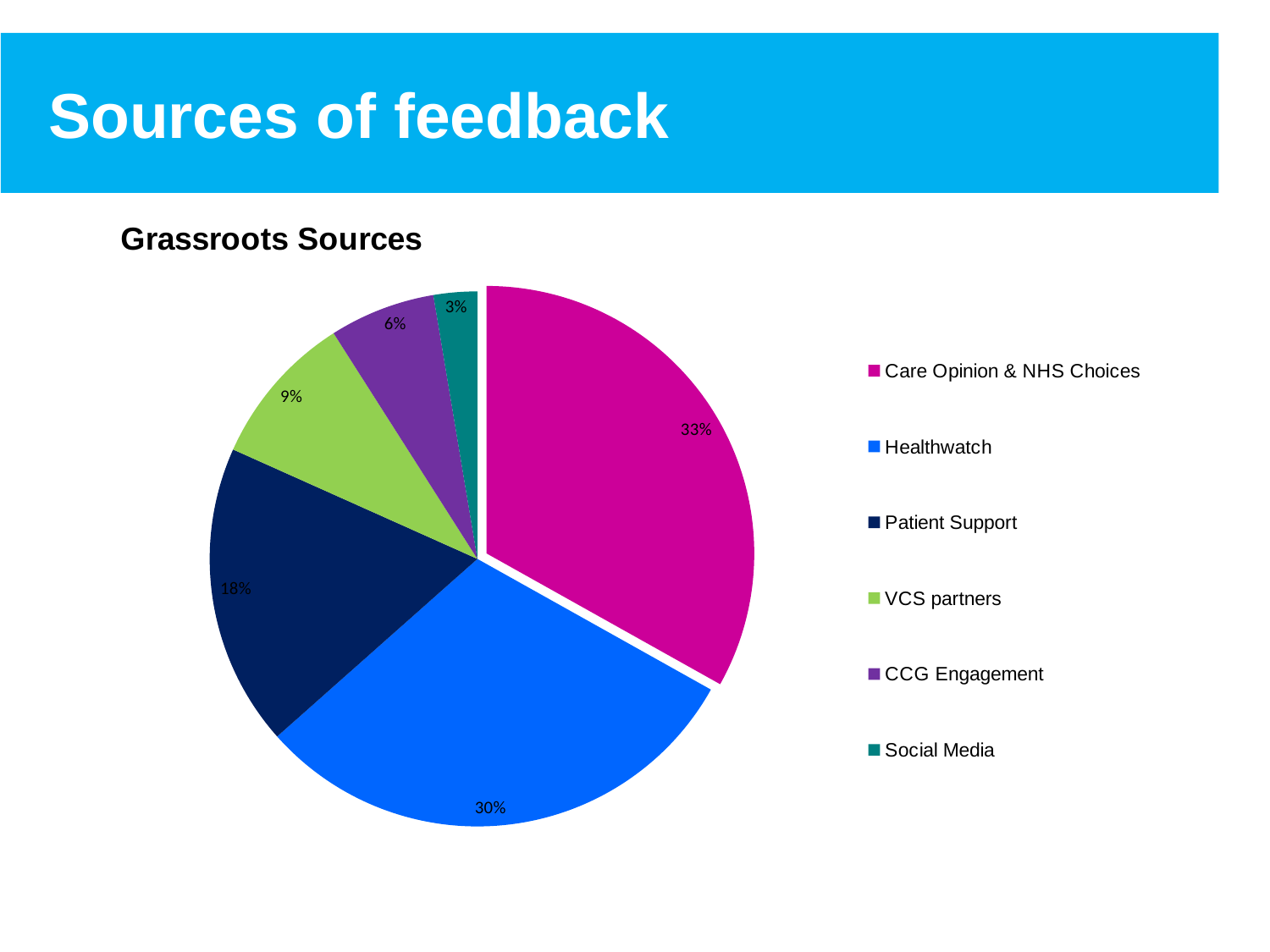
What is the title of the chart? Grassroots Sources What is the value shown for Healthwatch? 30% What is the difference in percentage points between Healthwatch and Patient Support? 12 Which source has the smallest share of the pie? Social Media What is the value shown for Social Media? 3% What is the value shown for VCS partners? 9% Which source has the largest share of the pie? Care Opinion & NHS Choices What is the value shown for Patient Support? 18% What kind of chart is shown on the slide? pie chart What share of the pie does Care Opinion & NHS Choices account for? 33% How many sources are shown in the pie chart? 6 Which is larger, the share for VCS partners or the share for CCG Engagement? VCS partners